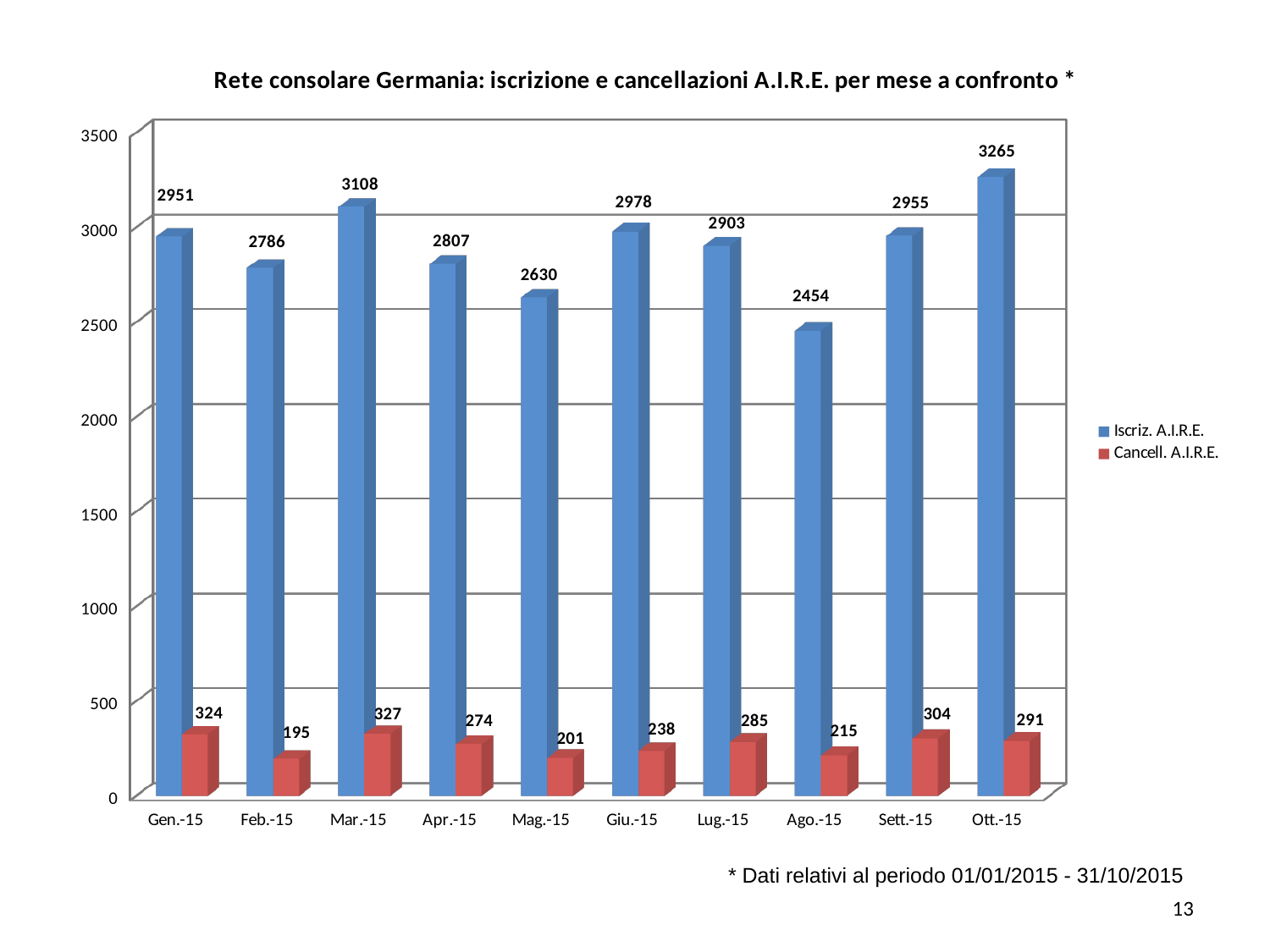
How many months are shown on the x axis? 10 How many series does the legend list? 2 Which month has the highest Iscriz. A.I.R.E. value? Ott.-15 Which month has the highest Cancell. A.I.R.E. value? Mar.-15 What is the Iscriz. A.I.R.E. value for Mar.-15? 3108 What kind of chart is shown on the slide? Bar chart What is the Cancell. A.I.R.E. value for Feb.-15? 195 Which month has the lowest Cancell. A.I.R.E. value? Feb.-15 Which month has the lowest Iscriz. A.I.R.E. value? Ago.-15 What is the difference between the Iscriz. A.I.R.E. values for Ott.-15 and Ago.-15? 811 What period do the data refer to, according to the footnote? 01/01/2015 - 31/10/2015 Which is larger, the Cancell. A.I.R.E. value for Gen.-15 or for Sett.-15? Gen.-15